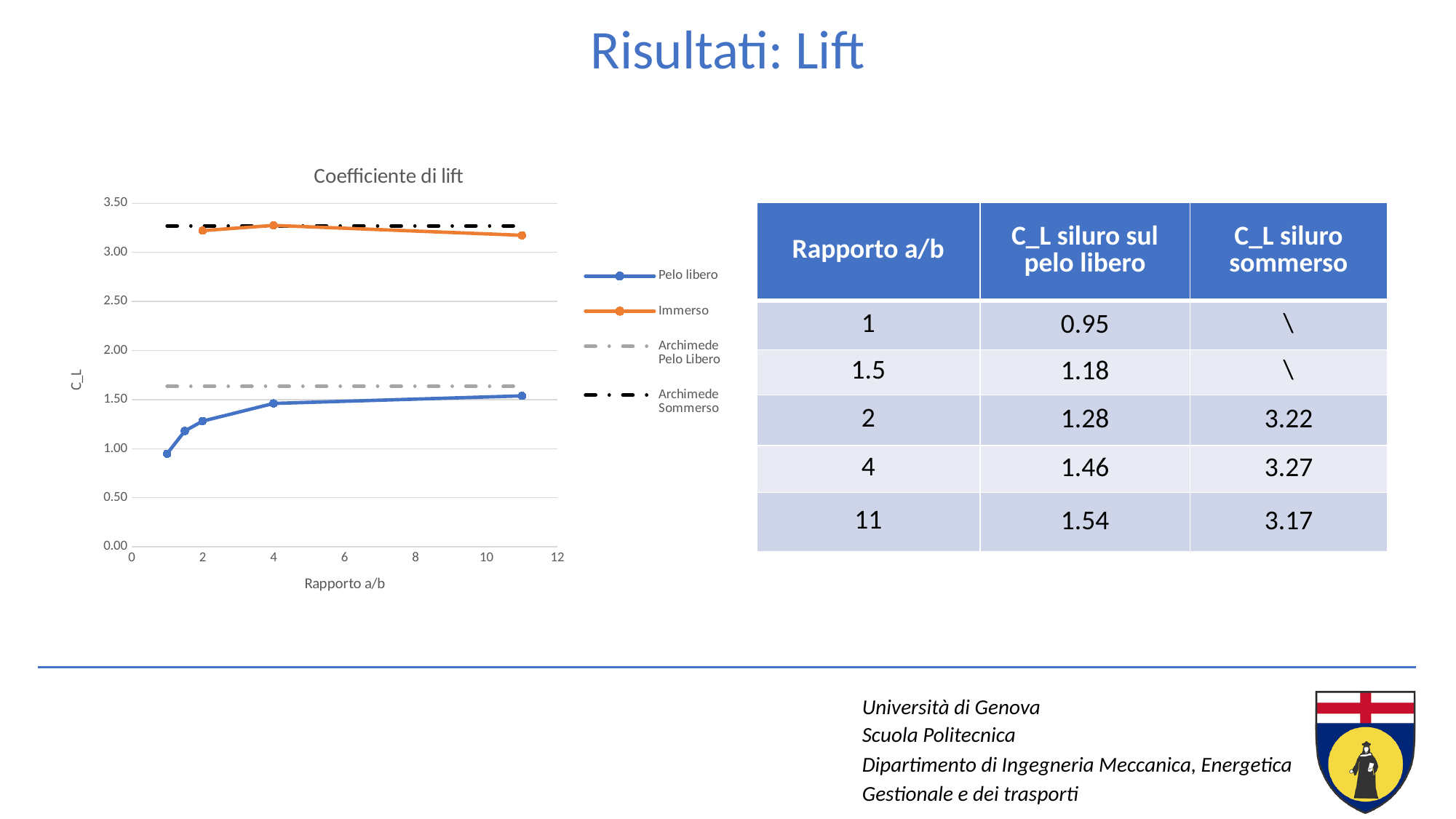
How many data points are plotted for the 'Immerso' series in the 'Coefficiente di lift' chart? 3 In the 'Coefficiente di lift' chart, is the value of the 'Immerso' series at Rapporto a/b = 11 greater or less than 3.00? greater What is the label of the x axis of the 'Coefficiente di lift' chart? Rapporto a/b How many data points are plotted for the 'Pelo libero' series in the 'Coefficiente di lift' chart? 5 In the 'Coefficiente di lift' chart, does the 'Pelo libero' series rise or fall as Rapporto a/b increases? rise In the 'Coefficiente di lift' chart, is the 'Archimede Pelo Libero' line greater or less than 1.50? greater What kind of chart is 'Coefficiente di lift'? line chart According to the slide, what is the difference between the C_L of the 'Immerso' series and the 'Pelo libero' series at Rapporto a/b = 11? 1.63 How many series does the legend of the 'Coefficiente di lift' chart list? 4 In the 'Coefficiente di lift' chart, which series is higher at Rapporto a/b = 2, 'Pelo libero' or 'Immerso'? Immerso According to the slide, at which Rapporto a/b does the 'Immerso' (siluro sommerso) series reach its highest C_L? 4 According to the slide, what is the C_L value of the 'Pelo libero' series at Rapporto a/b = 11? 1.54